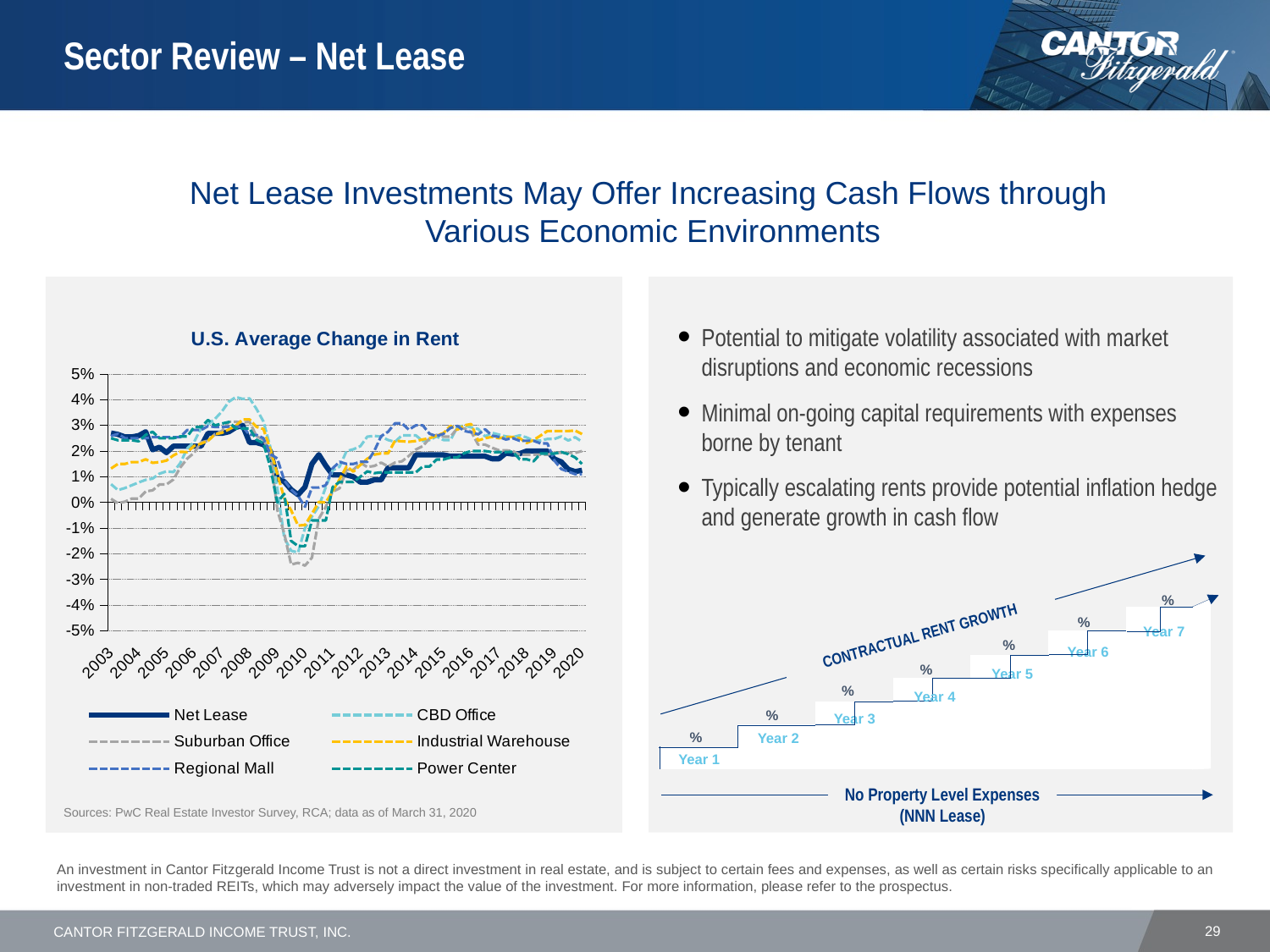
In the "U.S. Average Change in Rent" chart, does the Net Lease line rise or fall from 2017 to 2020? fall How many series does the legend of the "U.S. Average Change in Rent" chart list? 6 In the "U.S. Average Change in Rent" chart, which series falls to the lowest value around 2010? Suburban Office What is the title of the chart on the left side of the slide? U.S. Average Change in Rent In the "U.S. Average Change in Rent" chart, which series is drawn as a solid dark blue line? Net Lease In the "U.S. Average Change in Rent" chart, which series reaches the highest value around 2008? CBD Office In the "U.S. Average Change in Rent" chart, is the Net Lease value in 2003 greater or less than 2%? greater How many years are labeled on the x axis of the "U.S. Average Change in Rent" chart? 18 What kind of chart is "U.S. Average Change in Rent"? line chart What is the highest value shown on the y axis of the "U.S. Average Change in Rent" chart? 5%